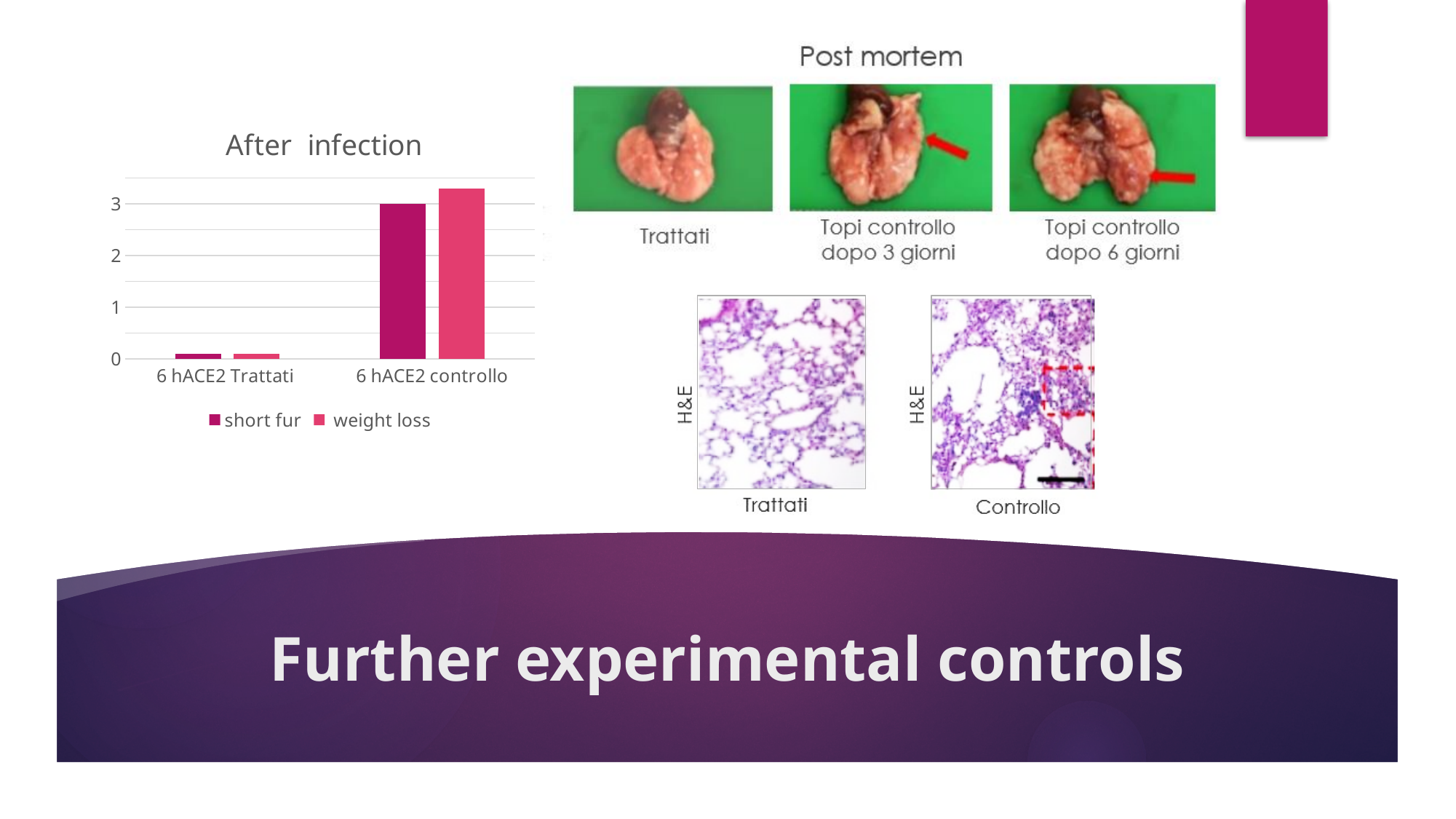
What type of chart is shown under the title "After infection"? bar chart What is the title of the chart on the left of the slide? After infection Which series are listed in the legend of the "After infection" chart? short fur, weight loss In the "After infection" chart, which category has the lower weight loss value? 6 hACE2 Trattati How many series does the legend of the "After infection" chart list? 2 In the "After infection" chart, is the weight loss value for 6 hACE2 Trattati greater or less than 1? less In the "After infection" chart, is the short fur value for 6 hACE2 Trattati greater or less than 1? less How many categories are shown on the x axis of the "After infection" chart? 2 In the "After infection" chart, is the weight loss value larger for 6 hACE2 Trattati or for 6 hACE2 controllo? 6 hACE2 controllo In the "After infection" chart, what is the short fur value for 6 hACE2 controllo? 3 In the "After infection" chart, which category has the higher short fur value? 6 hACE2 controllo In the "After infection" chart, is the weight loss value for 6 hACE2 controllo greater or less than 3? greater